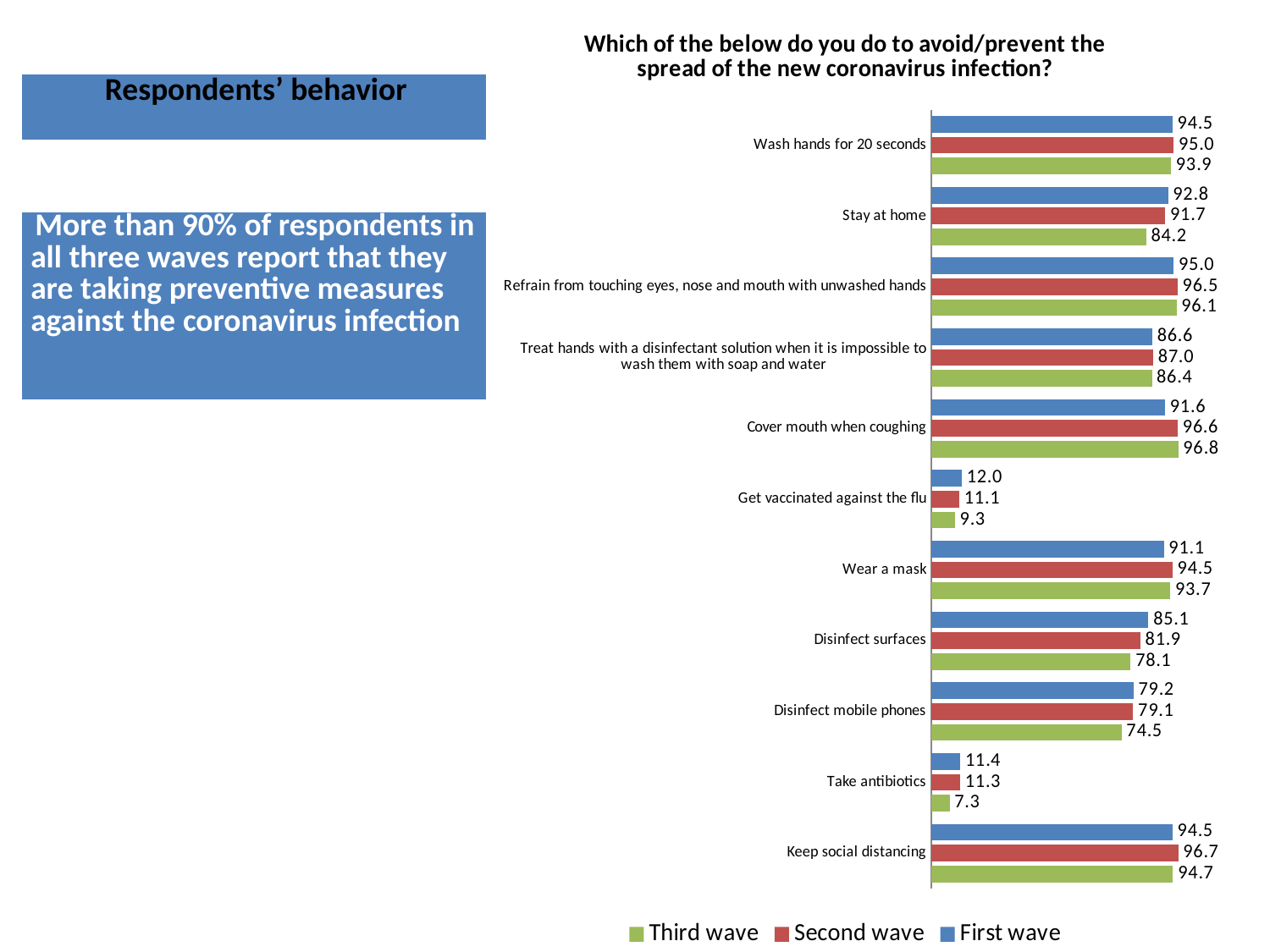
What is the First wave value for 'Stay at home'? 92.8 Which category has the highest First wave value? Refrain from touching eyes, nose and mouth with unwashed hands How many categories (preventive measures) are shown in the chart? 11 For 'Disinfect surfaces', which is larger: the First wave value or the Third wave value? First wave What is the difference between the First wave and Third wave values for 'Stay at home'? 8.6 Which category has the lowest Third wave value? Take antibiotics How many series does the legend list? 3 What is the Second wave value for 'Keep social distancing'? 96.7 What is the Third wave value for 'Get vaccinated against the flu'? 9.3 What is the difference between the First wave and Third wave values for 'Disinfect surfaces'? 7.0 What kind of chart is shown on the slide? Bar chart Which series is shown in green in the chart? Third wave